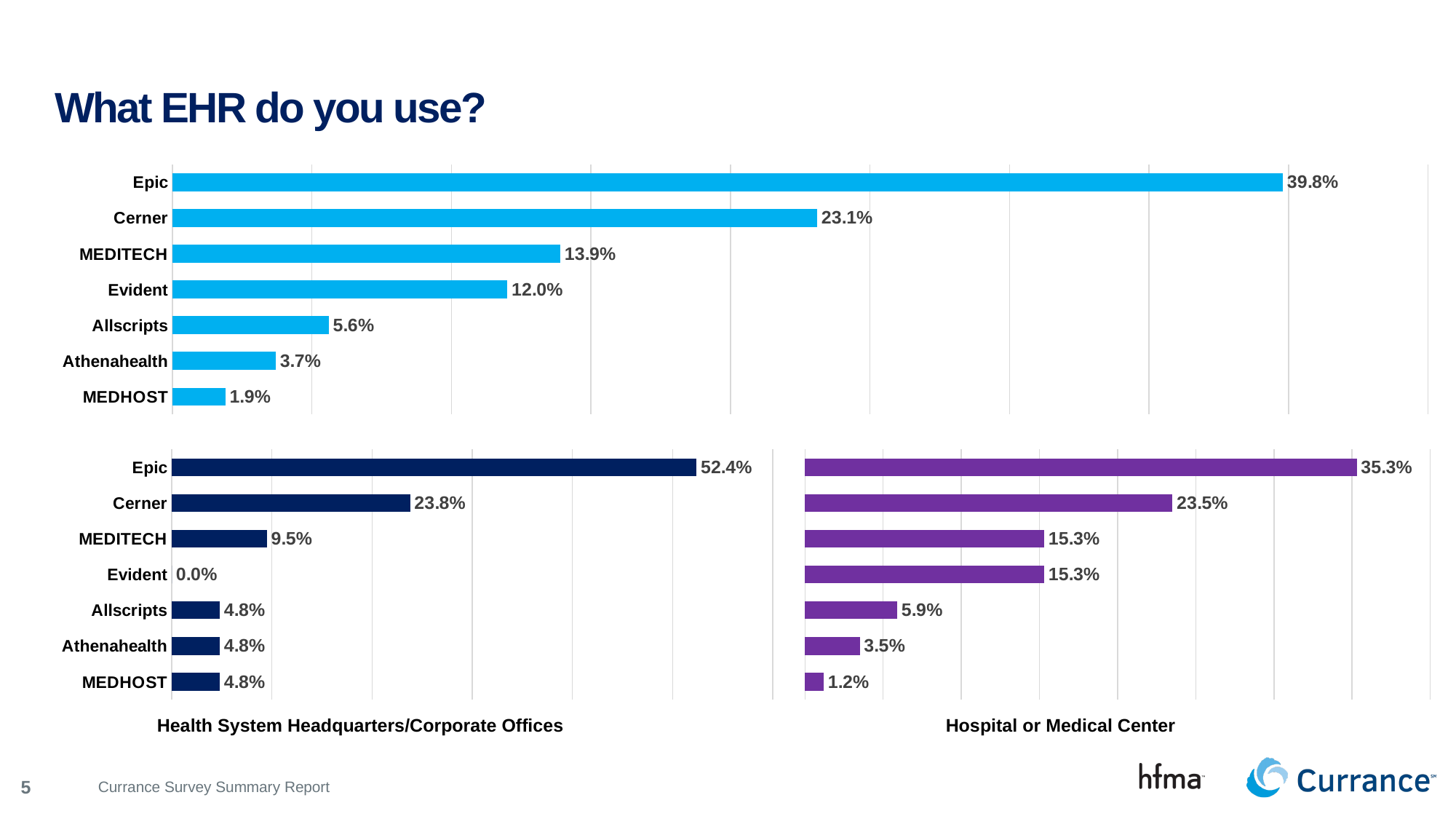
In the top chart, what is the difference between the values for Epic and Cerner? 16.7% In the top chart, which category has the lowest value? MEDHOST In the Hospital or Medical Center chart, what is the value for MEDITECH? 15.3% In the Hospital or Medical Center chart, which is larger, the value for Cerner or the value for Allscripts? Cerner In the top chart, what is the value for Epic? 39.8% In the Health System Headquarters/Corporate Offices chart, what is the value for Evident? 0.0% In the Health System Headquarters/Corporate Offices chart, which category has the highest value? Epic What kind of chart is the Health System Headquarters/Corporate Offices chart? Bar chart How many categories are shown in the Hospital or Medical Center chart? 7 In the Hospital or Medical Center chart, what is the value for MEDHOST? 1.2% In the Health System Headquarters/Corporate Offices chart, what is the value for Epic? 52.4% In the top chart, what is the value for Evident? 12.0%